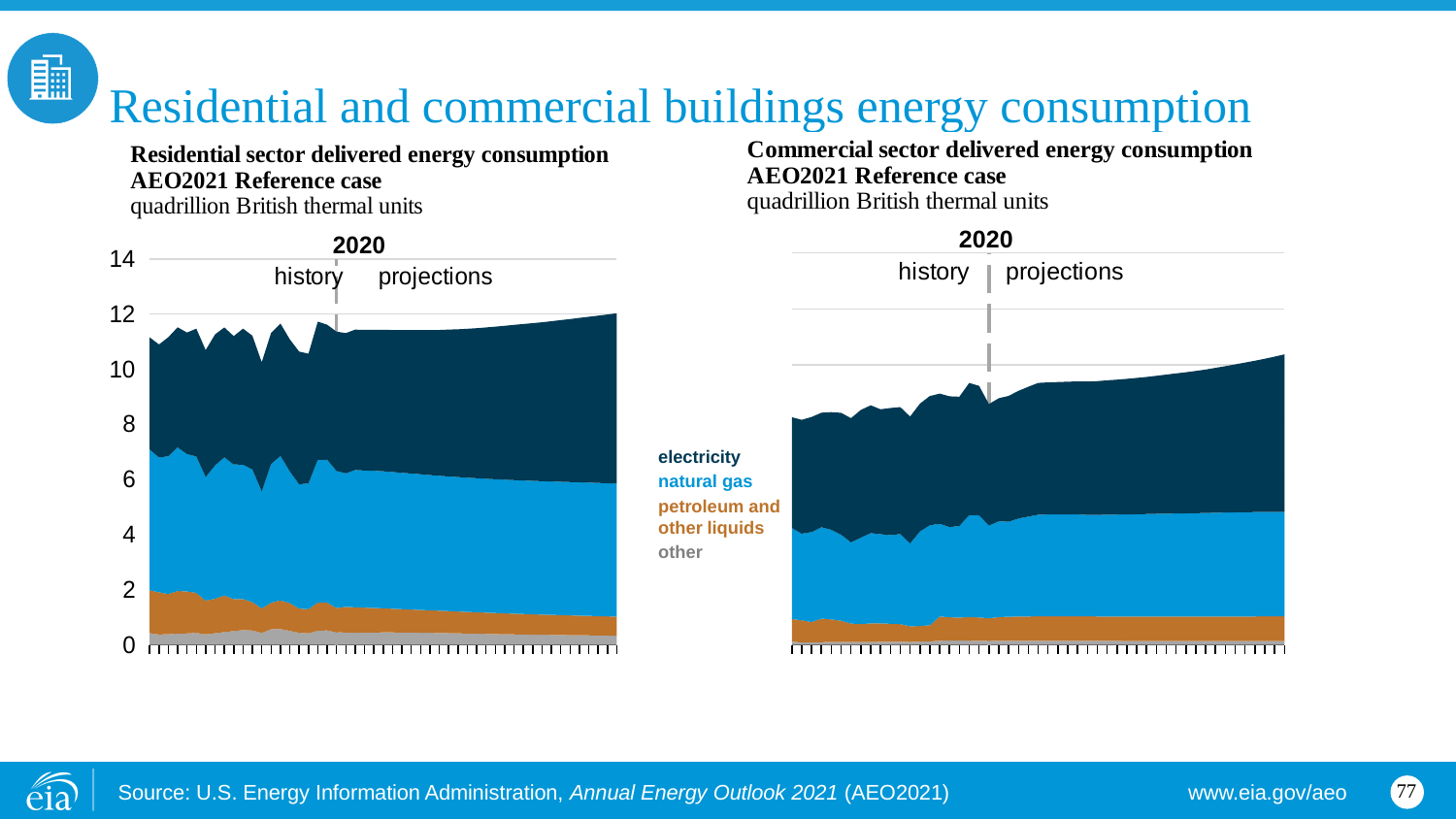
In the Residential sector chart, does total delivered energy consumption rise or fall over the projection period? rise In the Residential sector chart, is the top of the petroleum and other liquids layer in 2020 greater or less than 2? less Which sector has the larger total delivered energy consumption in 2020, residential or commercial? residential In the Residential sector chart, is the total delivered energy consumption in 2020 greater or less than 12? less In the Residential sector chart, is the total delivered energy consumption in 2020 greater or less than 10? greater In the Residential sector chart, what year does the dashed vertical line separating history from projections mark? 2020 What unit is used on the y axis of the Residential sector delivered energy consumption chart? quadrillion British thermal units How many series does the legend between the two charts list? 4 What kind of chart is the Residential sector delivered energy consumption chart? stacked area chart In the Commercial sector chart, does total delivered energy consumption rise or fall over the projection period? rise